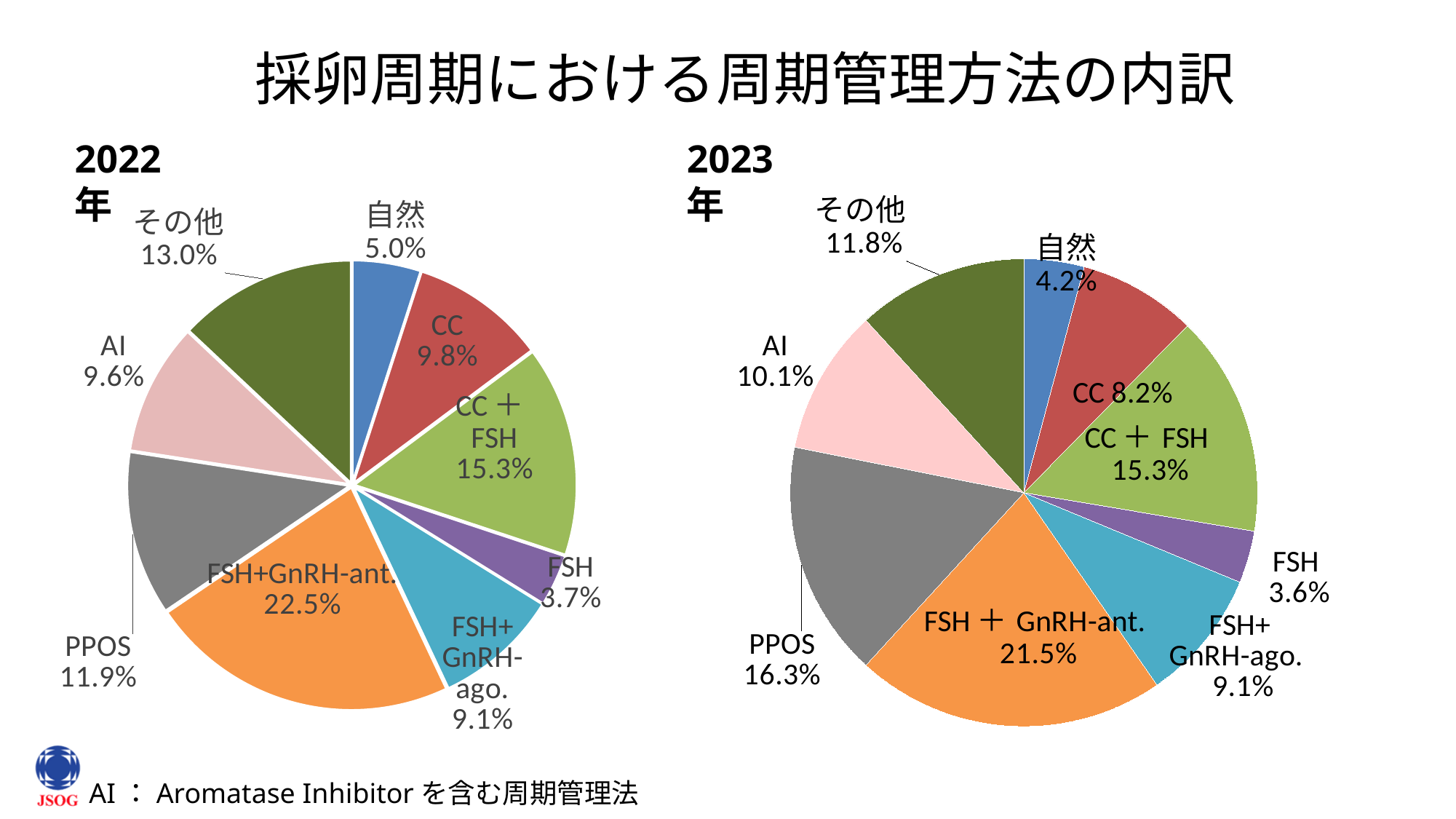
In the 2022年 pie chart, what share is labelled for FSH+GnRH-ant.? 22.5% How many slices does the 2023年 pie chart have? 9 In the 2022年 pie chart, which is larger: the share for その他 or the share for PPOS? その他 What type of chart is used on this slide? Pie chart In the 2022年 pie chart, what is the combined share of CC and CC＋FSH? 25.1% In the 2022年 pie chart, which category has the smallest slice? FSH In the 2022年 pie chart, which category has the largest slice? FSH+GnRH-ant. What is the difference between the PPOS share in the 2023年 chart and the PPOS share in the 2022年 chart? 4.4% In the 2023年 pie chart, which category has the smallest slice? FSH In the 2023年 pie chart, which is larger: the share for AI or the share for CC? AI In the 2023年 pie chart, what share is labelled for 自然? 4.2% In the 2023年 pie chart, what share is labelled for PPOS? 16.3%